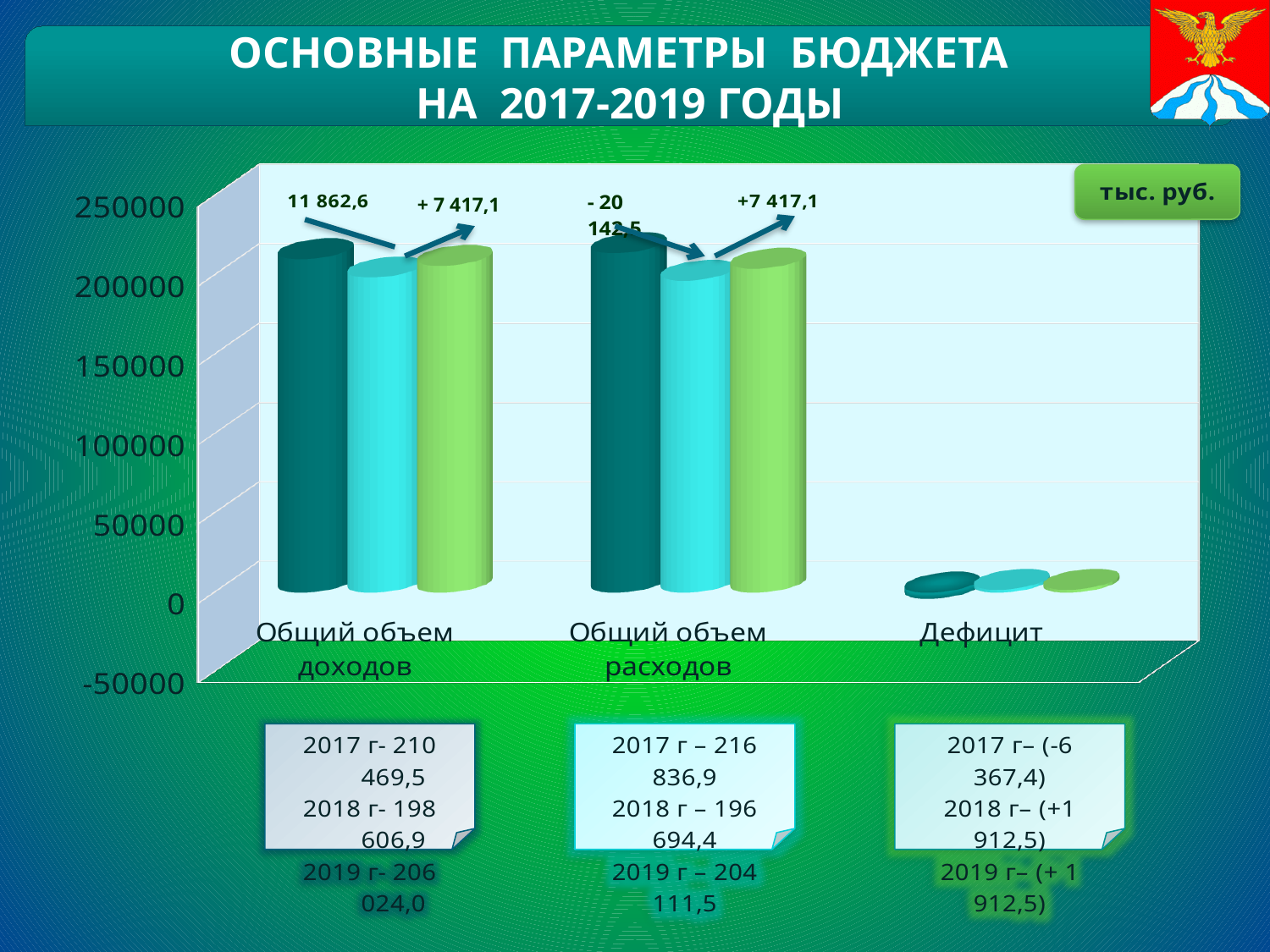
Is the value of Общий объем доходов for 2017 г greater or less than 200000? greater How many categories are shown on the x axis of the chart? 3 Is the value of Дефицит for 2018 г greater or less than 50000? less What is the value of Общий объем доходов for 2017 г? 210 469,5 Which is larger for 2017 г: Общий объем доходов or Общий объем расходов? Общий объем расходов What is the value of Дефицит for 2017 г? (-6 367,4) In what units are the chart values given, according to the label in the top right corner? тыс. руб. By how much does Общий объем доходов for 2018 г differ from 2017 г? 11 862,6 What is the value of Общий объем расходов for 2019 г? 204 111,5 What is the value of Общий объем доходов for 2018 г? 198 606,9 What kind of chart is shown on the slide? bar chart What is the value of Общий объем расходов for 2017 г? 216 836,9